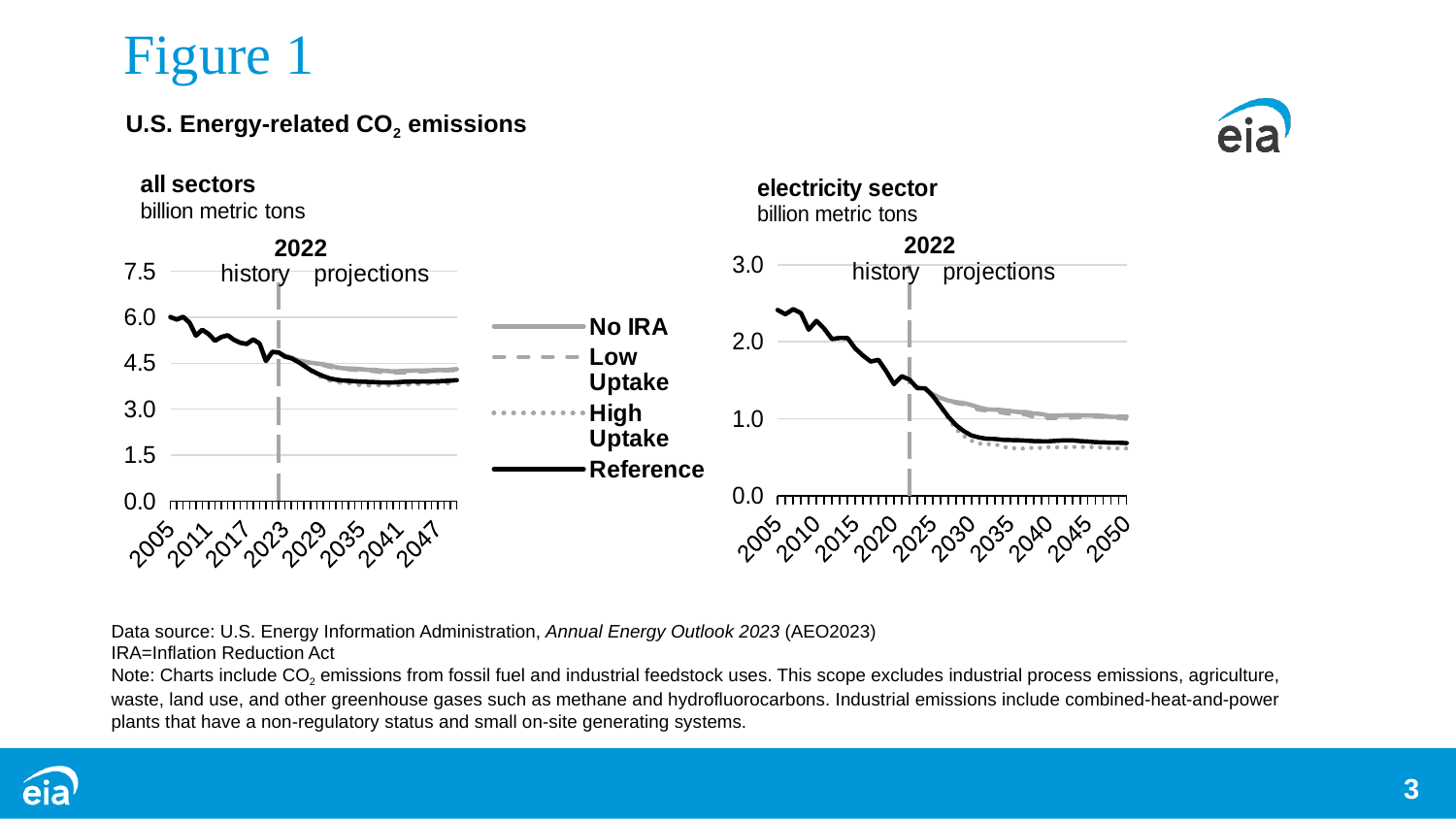
What unit is shown under the 'electricity sector' chart title? billion metric tons In the 'all sectors' chart, is the Reference value for 2047 greater or less than 4.5? less In the 'electricity sector' chart, is the value for 2005 greater or less than 2.0? greater What year does the vertical dashed line separating history from projections mark? 2022 In the 'electricity sector' chart, do the values generally rise or fall from 2005 to 2050? fall How many series does the legend list? 4 In the 'electricity sector' chart, is the Reference value for 2050 greater or less than 1.0? less In the 'all sectors' chart, which is higher in 2047: No IRA or Reference? No IRA In the 'electricity sector' chart, which is higher in 2050: No IRA or Reference? No IRA What kind of chart is the 'all sectors' chart? line chart